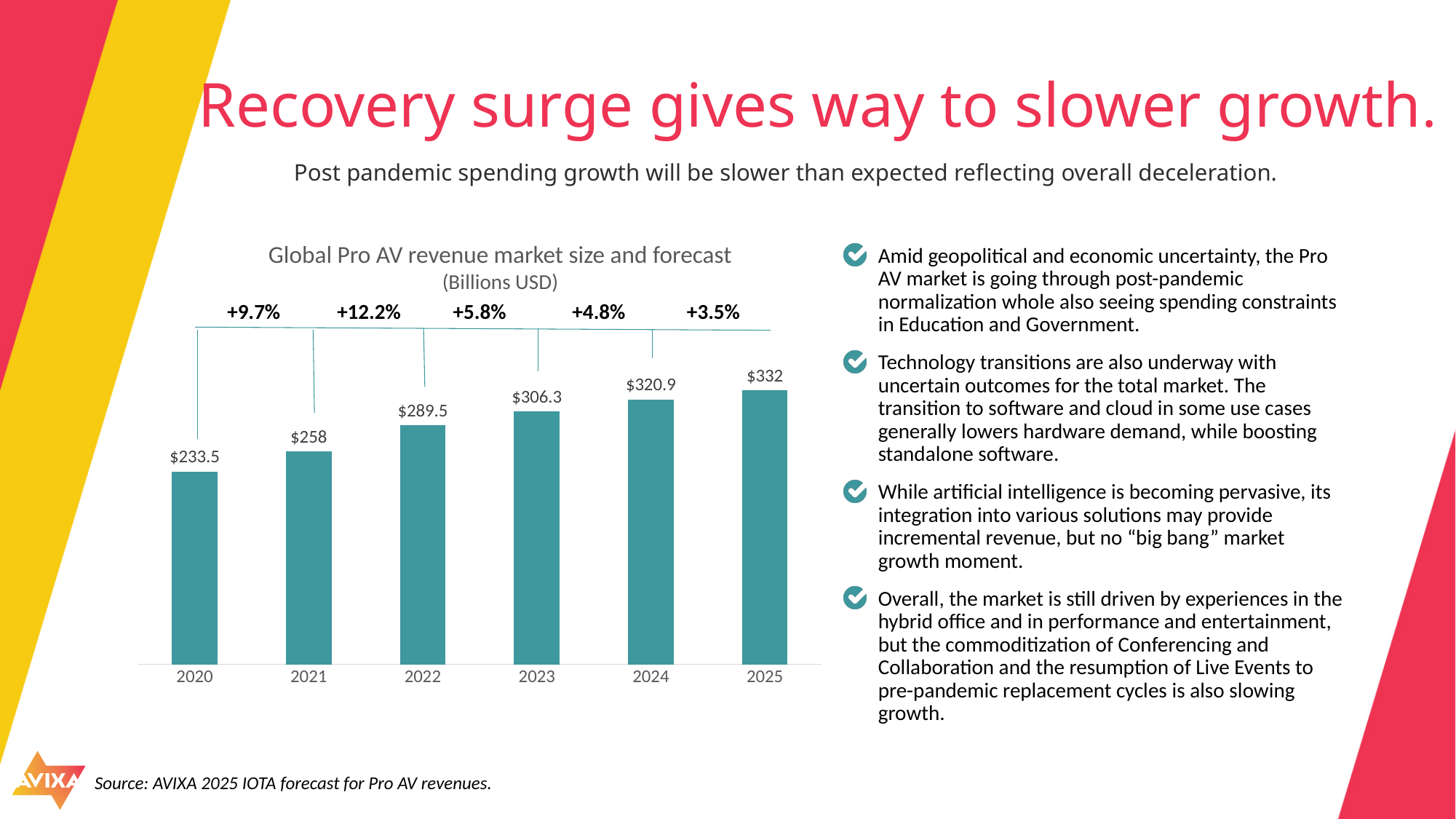
What is the difference between the values for 2022 and 2021? $31.5 What is the difference between the values for 2025 and 2020? $98.5 What kind of chart is this? Bar chart What growth percentage is shown between 2021 and 2022? +12.2% What is the value for 2020? $233.5 Which year has the highest value? 2025 What is the value for 2025? $332 Do the values rise or fall from 2020 to 2025? Rise How many years are shown on the chart? 6 What is the value for 2023? $306.3 Which year has the lowest value? 2020 Which is larger, the value for 2024 or the value for 2022? 2024